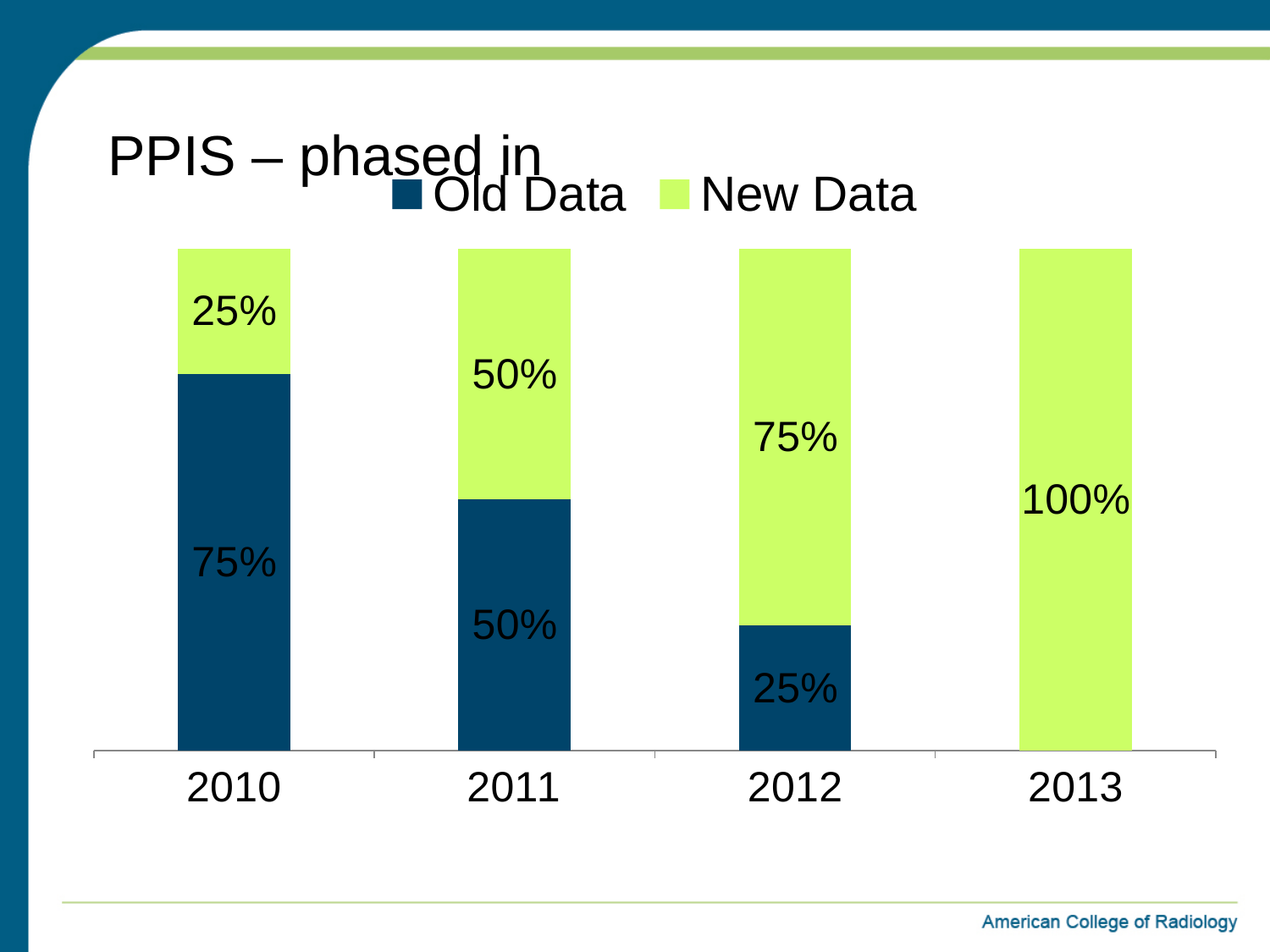
In which year is the New Data value highest? 2013 What is the value for Old Data in 2012? 25% What is the value for New Data in 2013? 100% What is the difference between the Old Data value in 2010 and the Old Data value in 2012? 50% What kind of chart is shown? Stacked bar chart In which year is the Old Data value lowest among the years where it is shown? 2012 How many series does the legend list? 2 How many years are shown on the x axis? 4 Which is larger in 2012, Old Data or New Data? New Data What is the value for New Data in 2010? 25% Does the New Data value rise or fall from 2010 to 2013? Rise What is the value for Old Data in 2011? 50%